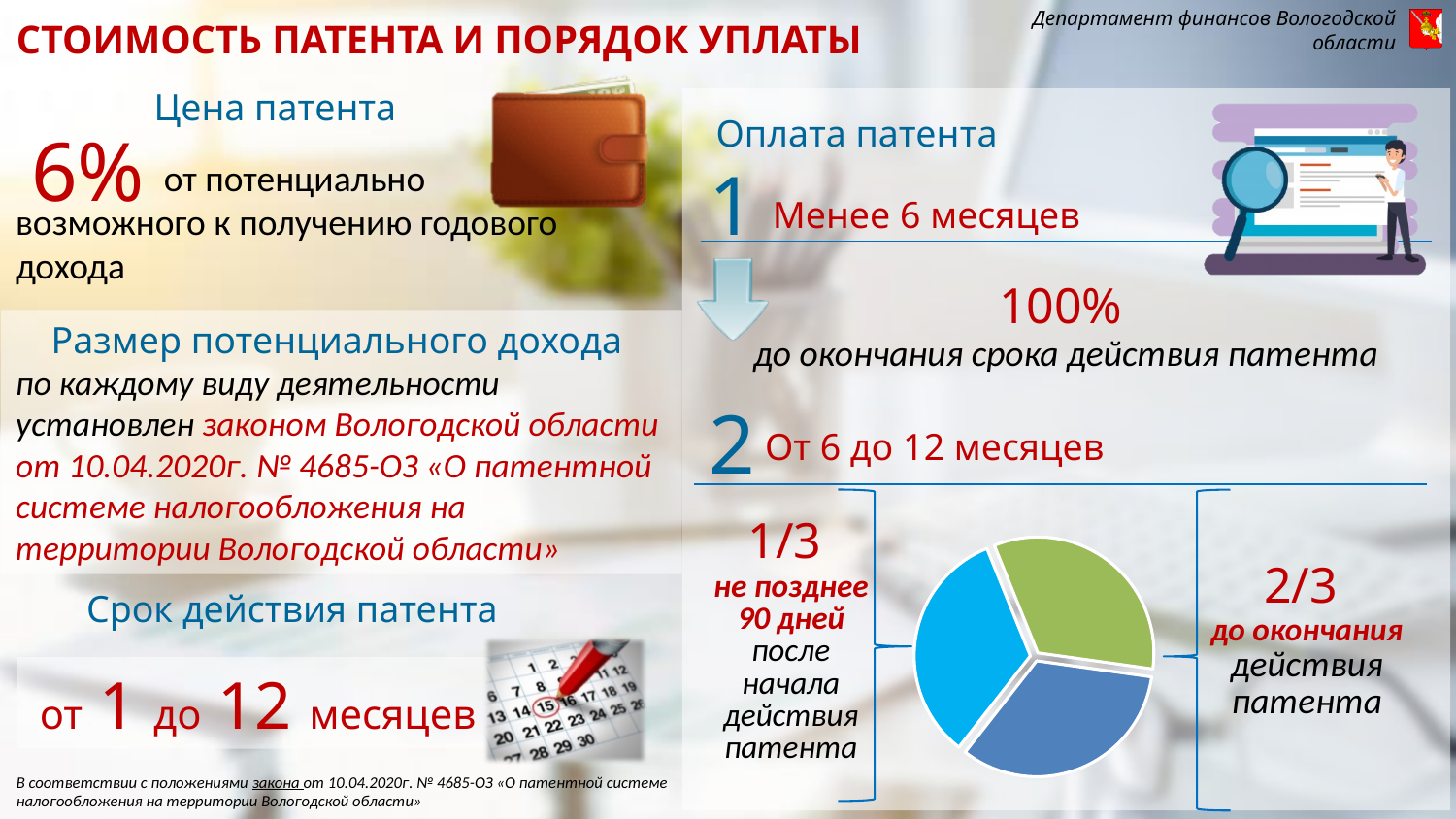
According to the label next to the pie chart, what share of the patent cost must be paid no later than 90 days after the patent starts? 1/3 How many slices does the pie chart have? 3 Which payment option does the pie chart illustrate: patents for less than 6 months or patents for 6 to 12 months? 6 to 12 months Which share shown beside the pie chart is larger: the one due within 90 days or the one due before the patent expires? the one due before the patent expires (2/3) What colours are the three slices of the pie chart? green, dark blue and light blue According to the label next to the pie chart, what share of the patent cost must be paid before the end of the patent's validity? 2/3 What kind of chart is shown on the slide? pie chart